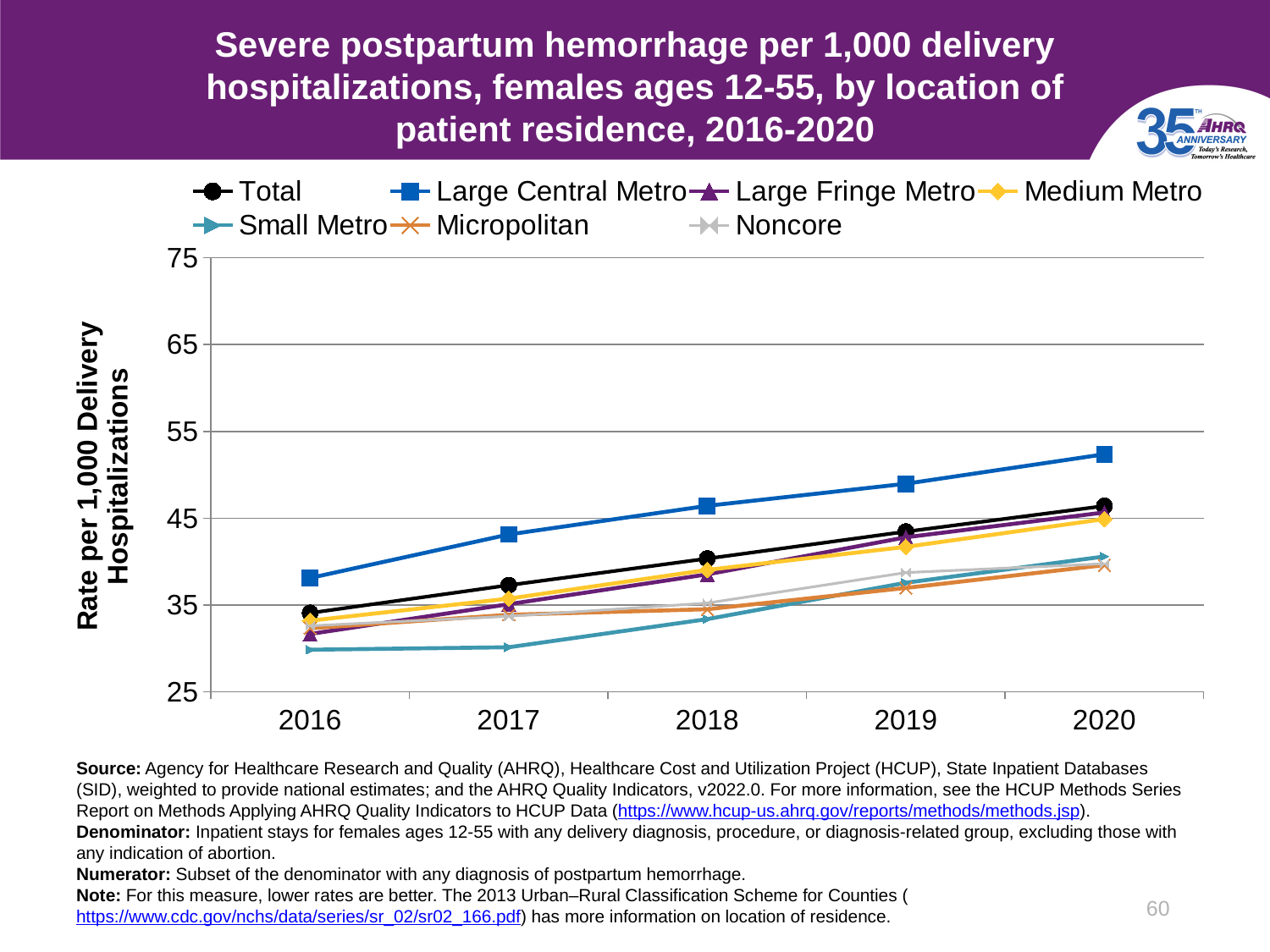
What kind of chart is shown on the slide? line chart Which series has the highest value in 2016? Large Central Metro What is the title of the y axis? Rate per 1,000 Delivery Hospitalizations Is the value for Small Metro in 2016 greater or less than 35? less Which series has the highest value in 2020? Large Central Metro Is the value for Large Central Metro in 2020 greater or less than 45? greater Is the value for Large Central Metro in 2016 greater or less than 35? greater How many years are plotted along the x axis? 5 How many series does the legend list? 7 In 2018, which is larger: the value for Large Central Metro or the value for Small Metro? Large Central Metro Does the Large Central Metro series rise or fall from 2016 to 2020? rise